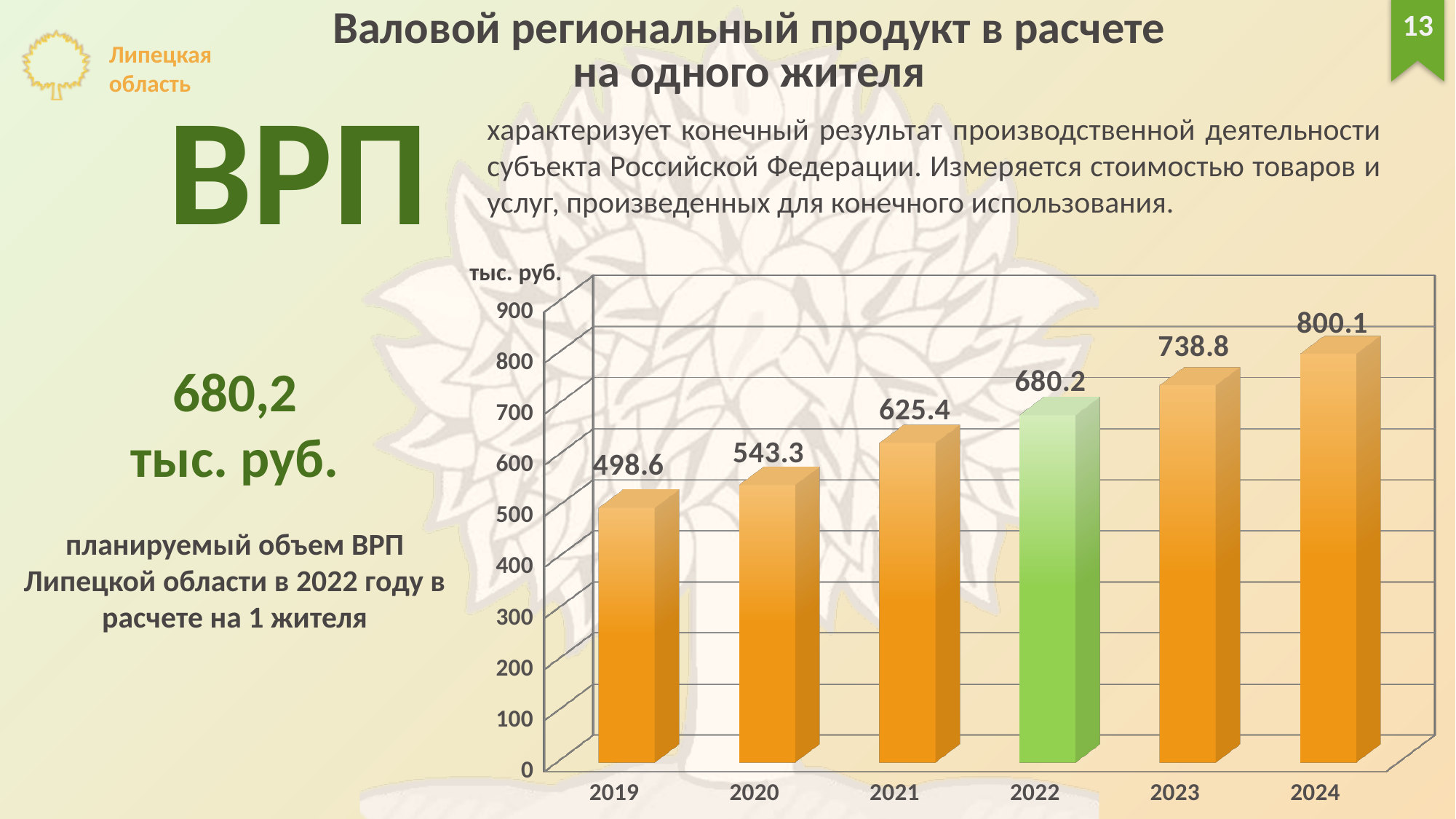
Which year has the lowest value? 2019 Do the values rise or fall from 2019 to 2024? rise What is the difference between the values for 2023 and 2022? 58.6 What is the difference between the values for 2020 and 2019? 44.7 Which year has the highest value? 2024 Is the value for 2023 greater or less than 700? greater What is the value for 2024? 800.1 What is the value for 2022? 680.2 What is the value for 2019? 498.6 Which is larger, the value for 2021 or the value for 2020? 2021 How many years are shown on the x axis? 6 What kind of chart is shown? bar chart